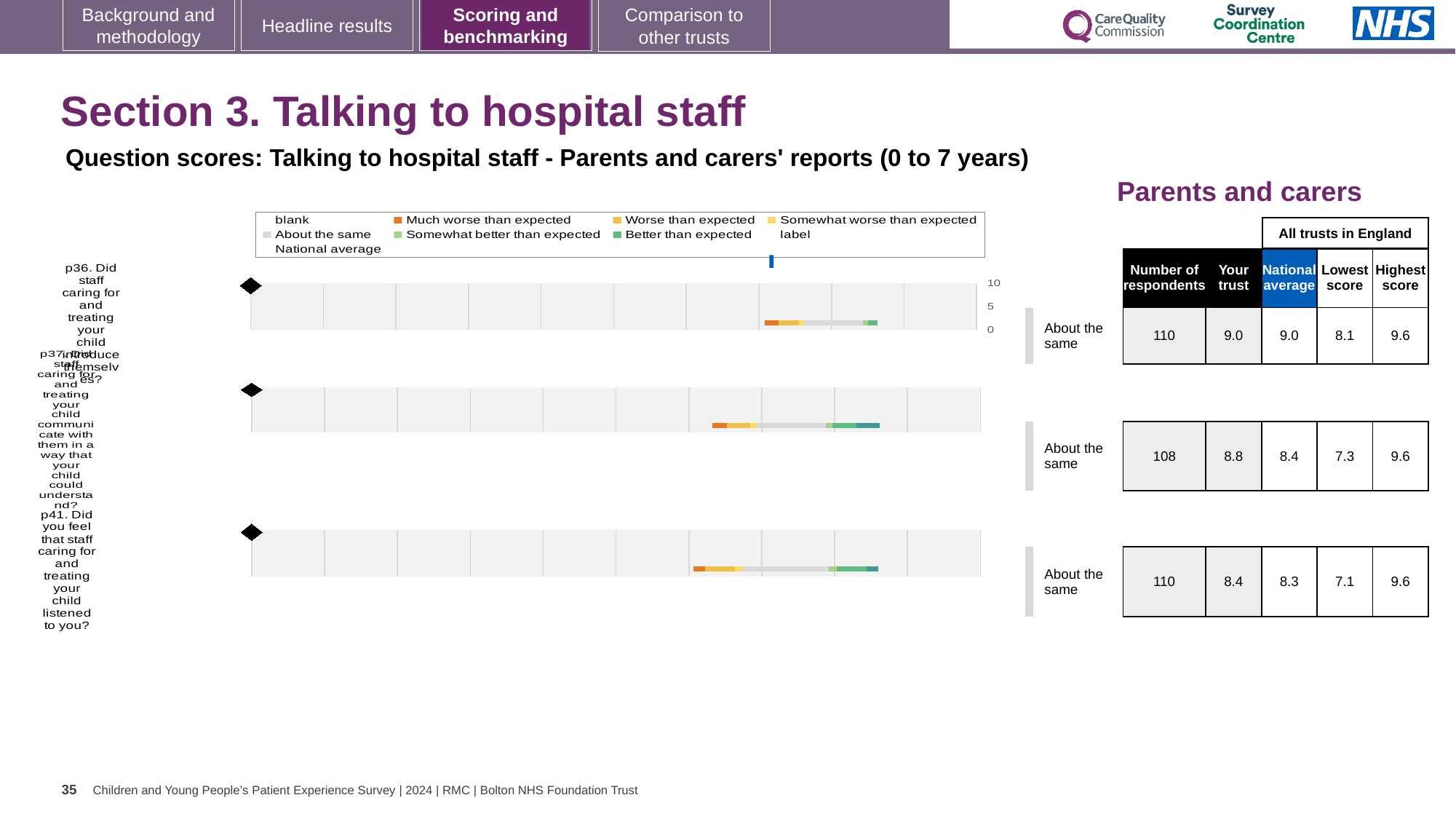
What is the lowest score among all trusts in England for p41 (Did you feel that staff caring for and treating your child listened to you)? 7.1 What is the difference between the 'Your trust' score and the national average for p37? 0.4 Which question has the highest 'Your trust' score? p36 Is the 'Your trust' score for p41 greater or less than 5 on the chart axis? greater What is the 'Your trust' score for p36 (Did staff caring for and treating your child introduce themselves)? 9.0 For p41, which is larger: the 'Your trust' score or the national average? Your trust How many questions (bars) are plotted in the chart? 3 What comparison label is given for p36 next to the chart? About the same How many respondents answered p37? 108 What kind of chart is shown on the slide? bar chart What is the national average score for p37 (Did staff communicate with them in a way that your child could understand)? 8.4 Which question has the lowest 'Your trust' score? p41